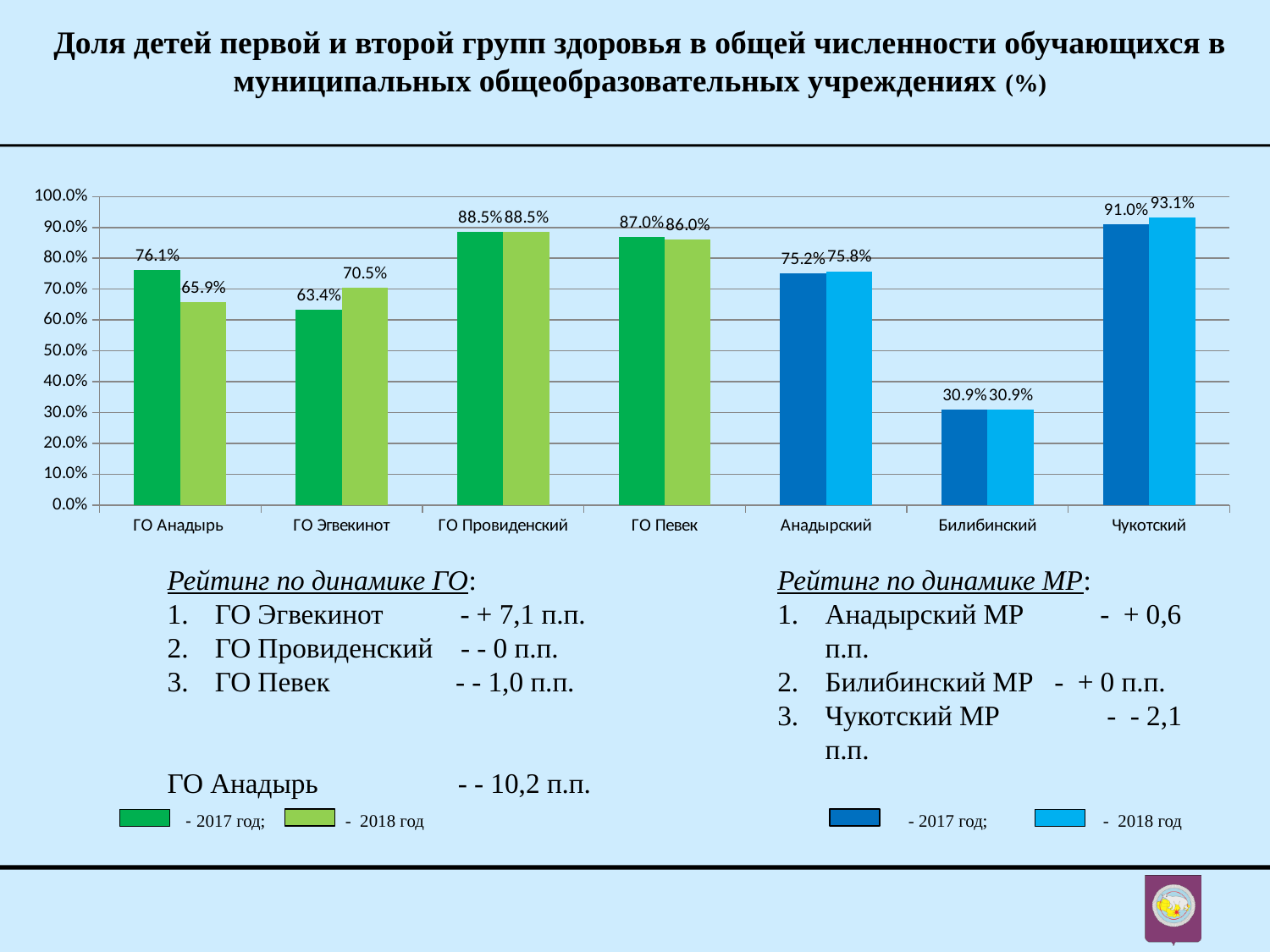
Which category has the lowest 2018 value? Билибинский What kind of chart is shown on the slide? bar chart What is the 2018 value for Чукотский? 93.1% Did the value for ГО Певек rise or fall from 2017 to 2018? fall Which category has the highest 2018 value? Чукотский Which is larger for Анадырский: the 2017 value or the 2018 value? 2018 What is the 2017 value for ГО Анадырь? 76.1% How many categories are shown on the x axis? 7 Is the 2017 value for Билибинский greater or less than 40.0%? less What is the 2018 value for ГО Эгвекинот? 70.5% What is the difference between the 2017 and 2018 values for ГО Анадырь? 10.2 percentage points Which year does the dark blue bar represent according to the legend? 2017